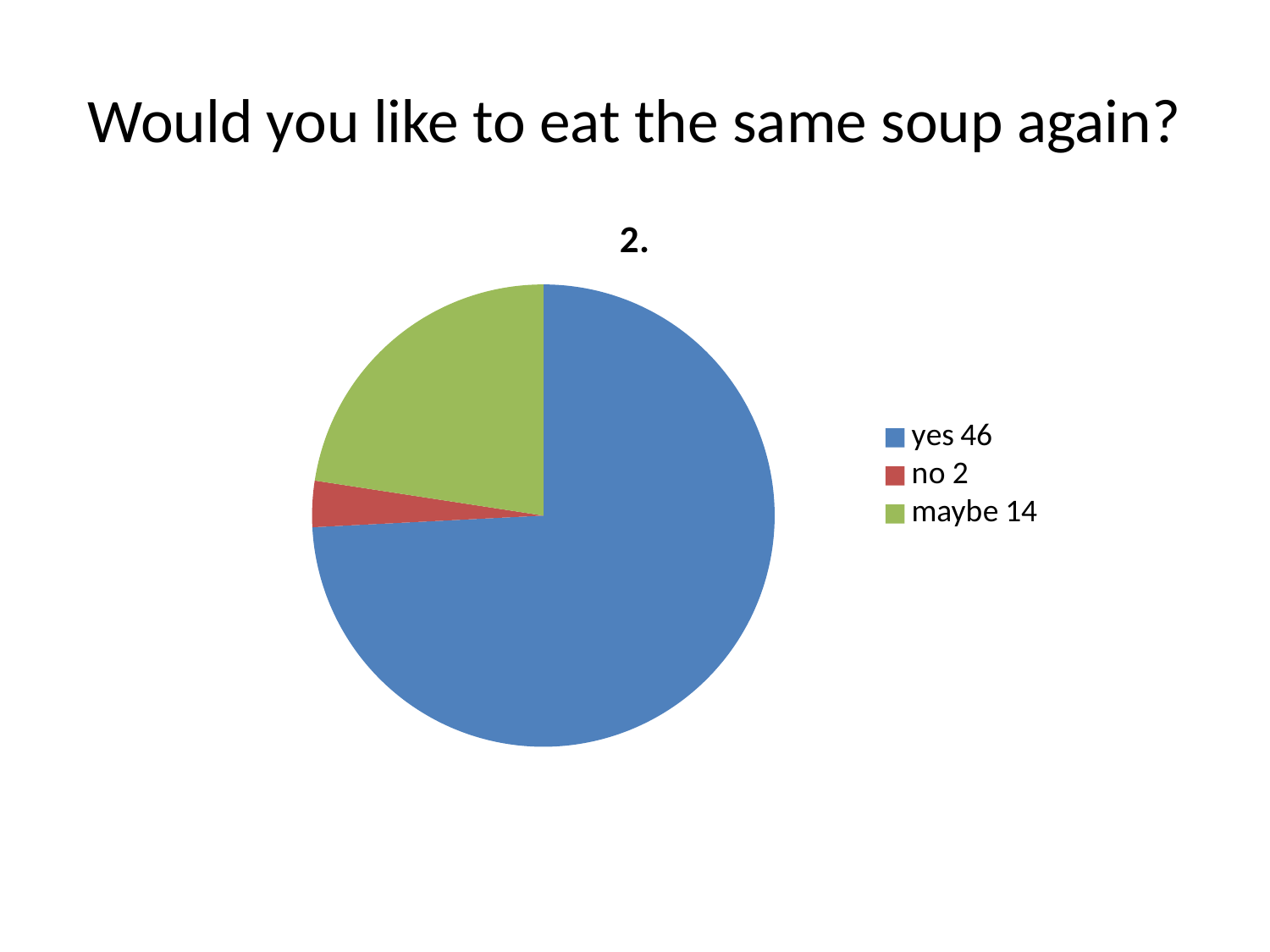
How many entries does the legend list? 3 According to the legend, how many people answered "yes"? 46 How many slices does the pie chart have? 3 Which response has the smallest slice of the pie? no What colour is the "maybe" slice of the pie? green What is the total number of responses shown in the legend? 62 Which response received more answers, "maybe" or "no"? maybe What kind of chart is shown on the slide? pie chart According to the legend, how many people answered "no"? 2 What is the difference between the number of "yes" responses and the number of "maybe" responses? 32 According to the legend, how many people answered "maybe"? 14 Which response has the largest slice of the pie? yes